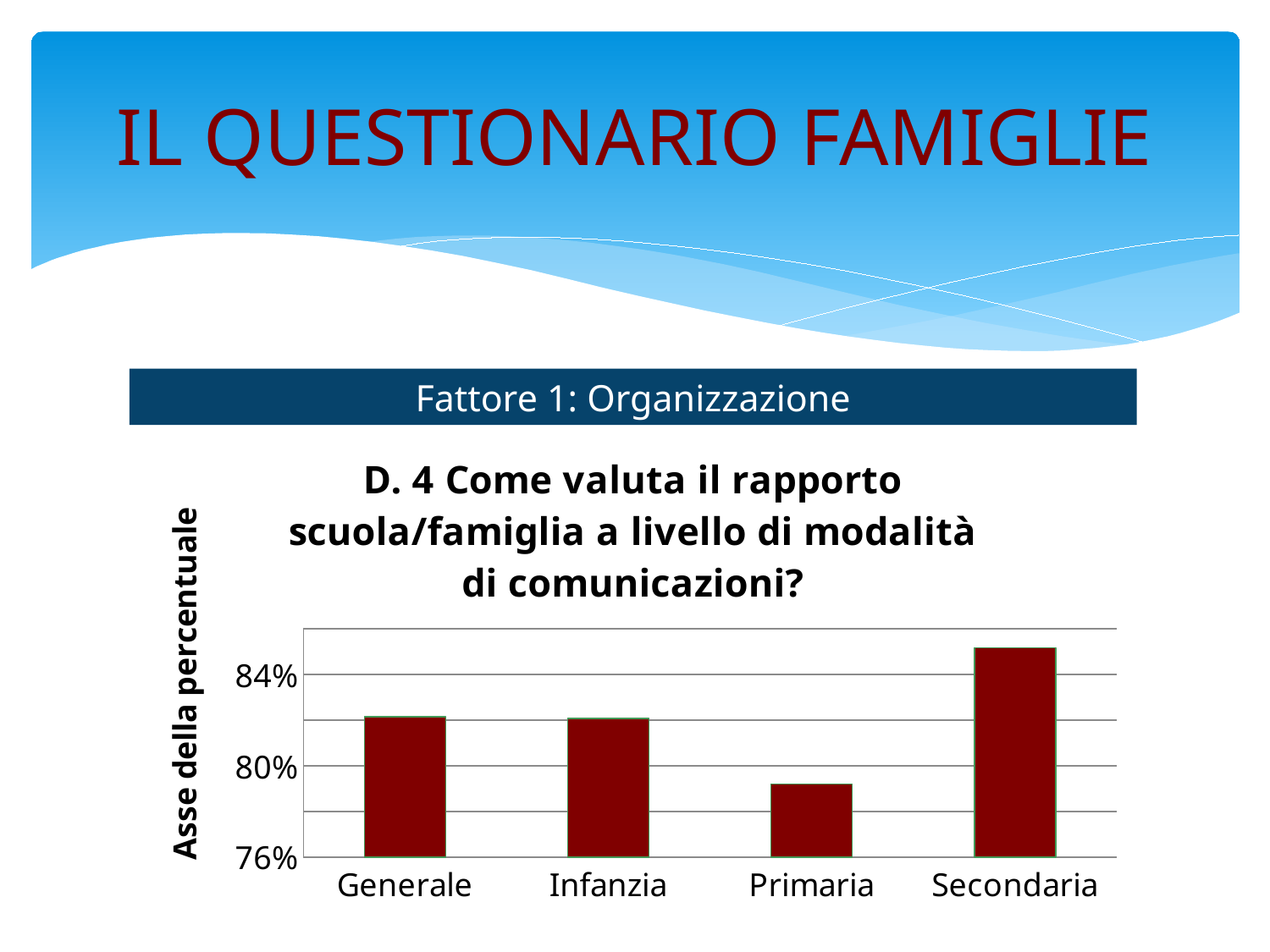
What kind of chart is shown on the slide? bar chart Is the value for Infanzia greater or less than 84%? less Is the value for Secondaria greater or less than 84%? greater Which category has the lowest value in the chart? Primaria What is the title of the chart? D. 4 Come valuta il rapporto scuola/famiglia a livello di modalità di comunicazioni? Which is larger, the value for Generale or the value for Primaria? Generale Is the value for Generale greater or less than 80%? greater How many categories are shown on the x axis of the chart? 4 What is the label of the vertical axis of the chart? Asse della percentuale Which is larger, the value for Secondaria or the value for Primaria? Secondaria Which category has the highest value in the chart? Secondaria